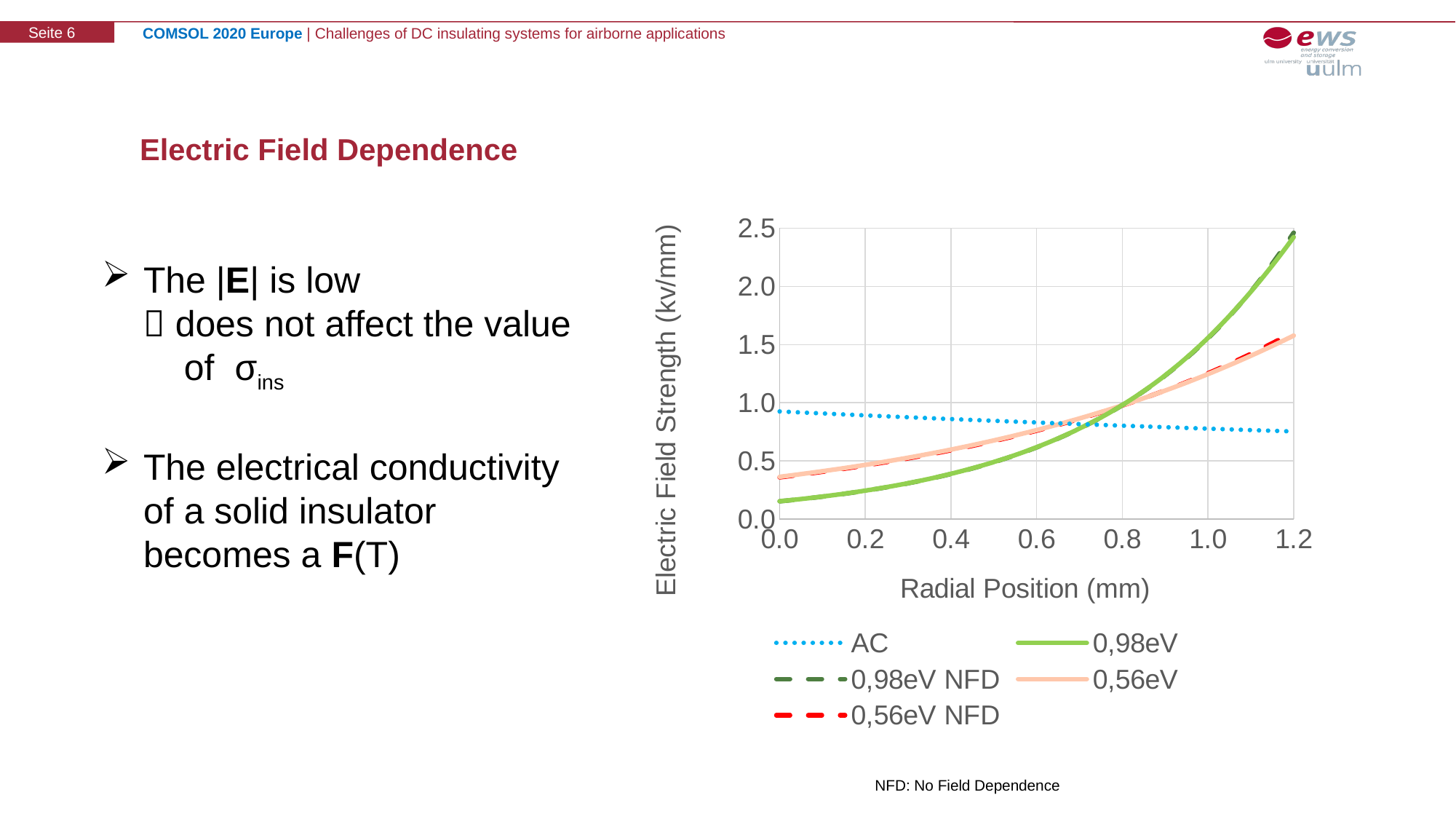
At radial position 0.0 mm, which series has the larger value, AC or 0,98eV? AC Is the value of the 0,98eV series at radial position 1.2 mm greater or less than 2.0? greater What kind of chart is shown on the slide? line chart Does the AC series rise or fall as radial position increases? fall Does the 0,98eV series rise or fall as radial position increases? rise Is the value of the AC series at radial position 0.0 mm greater or less than 1.0? less How many series does the chart's legend list? 5 Is the value of the 0,56eV series at radial position 1.2 mm greater or less than 1.0? greater What is the label of the y axis of the chart? Electric Field Strength (kv/mm) At radial position 1.2 mm, which series has the larger value, 0,98eV or 0,56eV? 0,98eV What is the label of the x axis of the chart? Radial Position (mm)